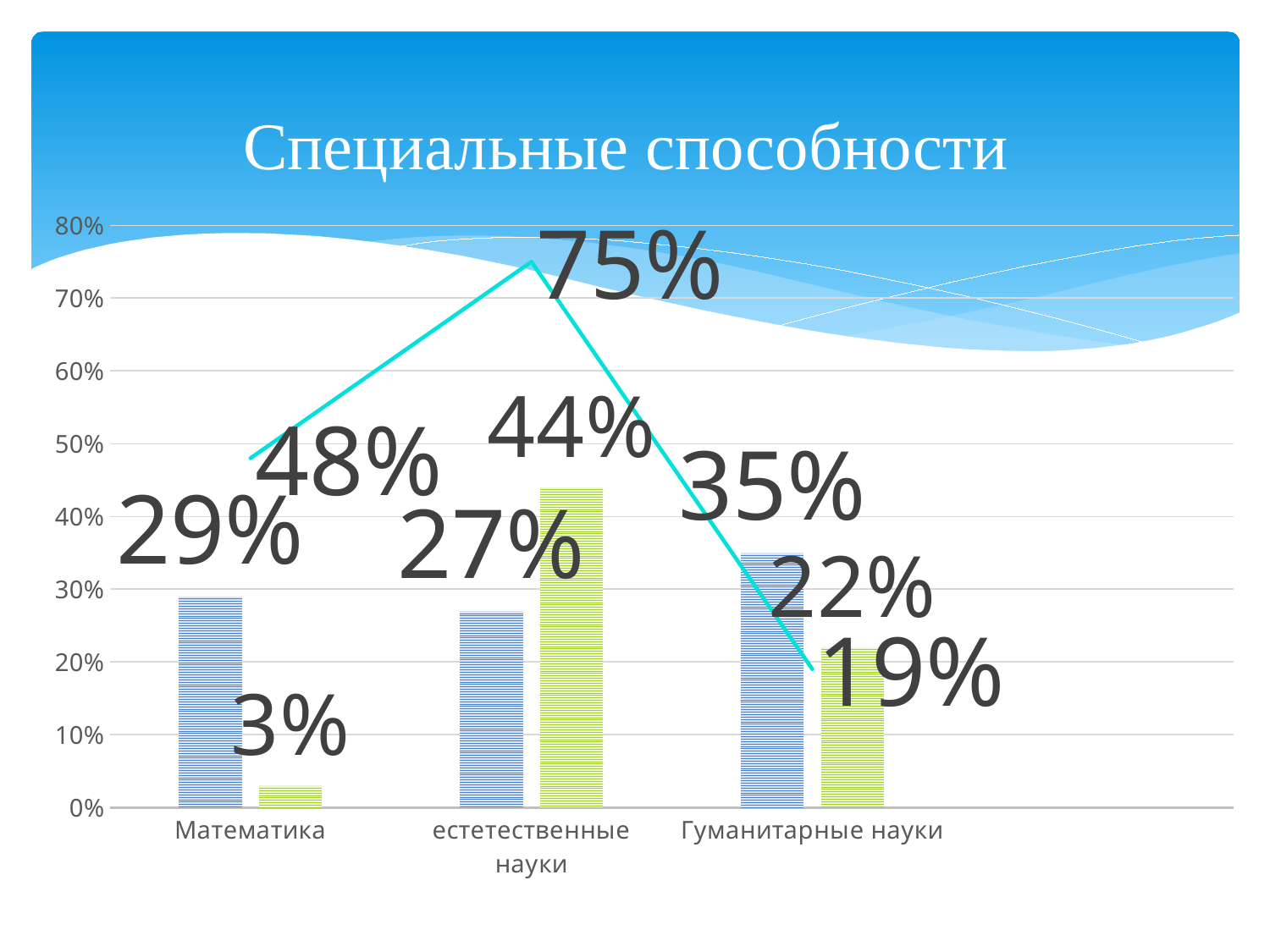
Does the line rise or fall from естетественные науки to Гуманитарные науки? fall What is the value of the line at естетественные науки? 75% What is the value of the green bar for Математика? 3% Which category has the lowest green bar? Математика Which category has the highest value on the line? естетественные науки What is the value of the green bar for естетественные науки? 44% What is the difference between the green bar and the blue bar for естетественные науки? 17% What is the value of the blue bar for Математика? 29% What is the value of the blue bar for Гуманитарные науки? 35% What is the title of the chart? Специальные способности How many categories are shown on the x axis? 3 Which is larger for Гуманитарные науки, the blue bar or the green bar? the blue bar